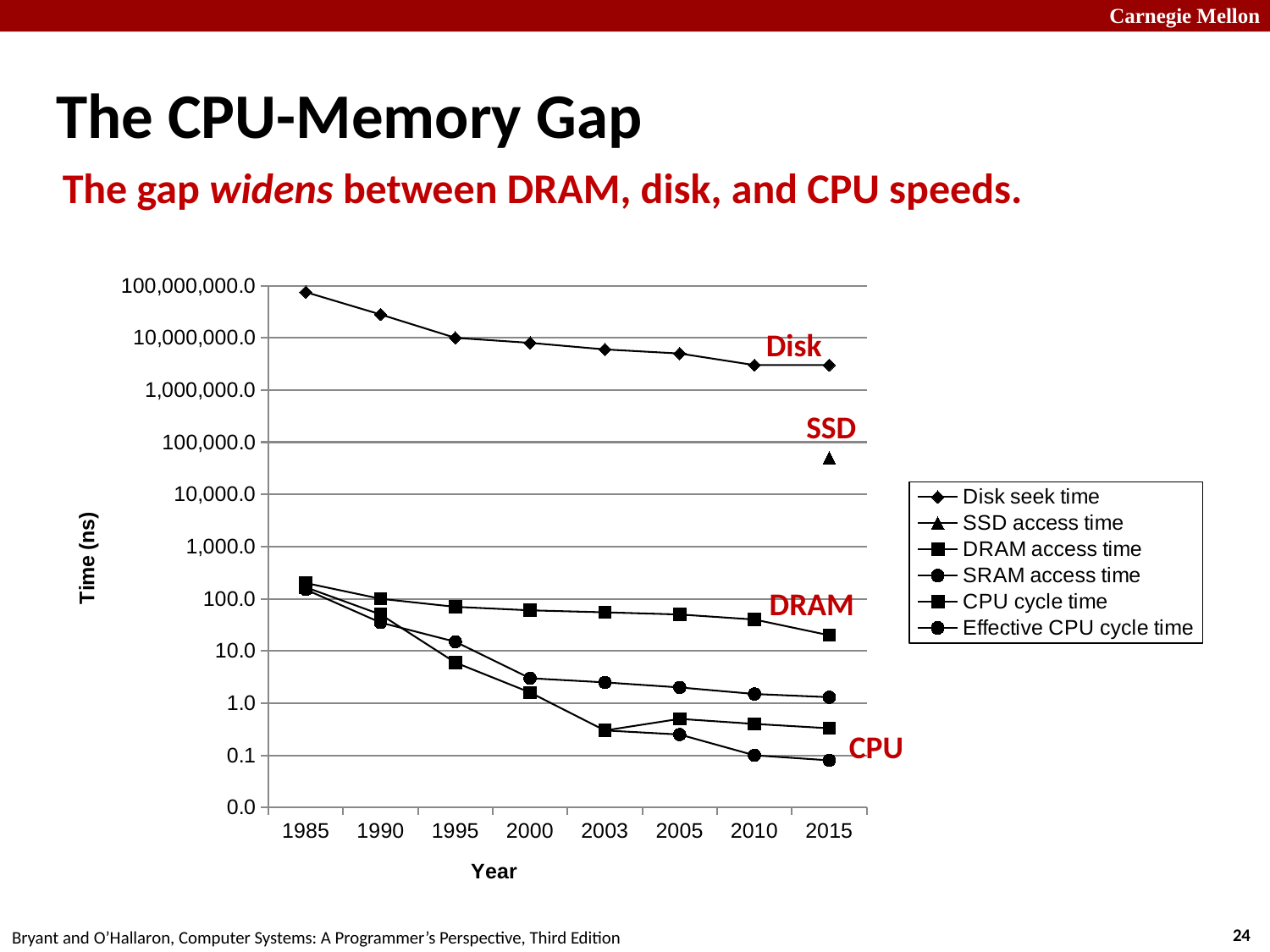
What kind of chart is shown on the slide? line chart Does the Disk seek time rise or fall from 1985 to 2015? fall What is the label of the y axis? Time (ns) Is the Disk seek time in 1985 greater or less than 10,000,000.0? greater How many series does the legend list? 6 Is the DRAM access time in 2015 greater or less than 100.0? less What is the label of the x axis? Year Is the SSD access time in 2015 greater or less than 100,000.0? less In 2015, which is larger: Disk seek time or DRAM access time? Disk seek time Which series has the highest value in 1985? Disk seek time How many years are marked along the x axis? 8